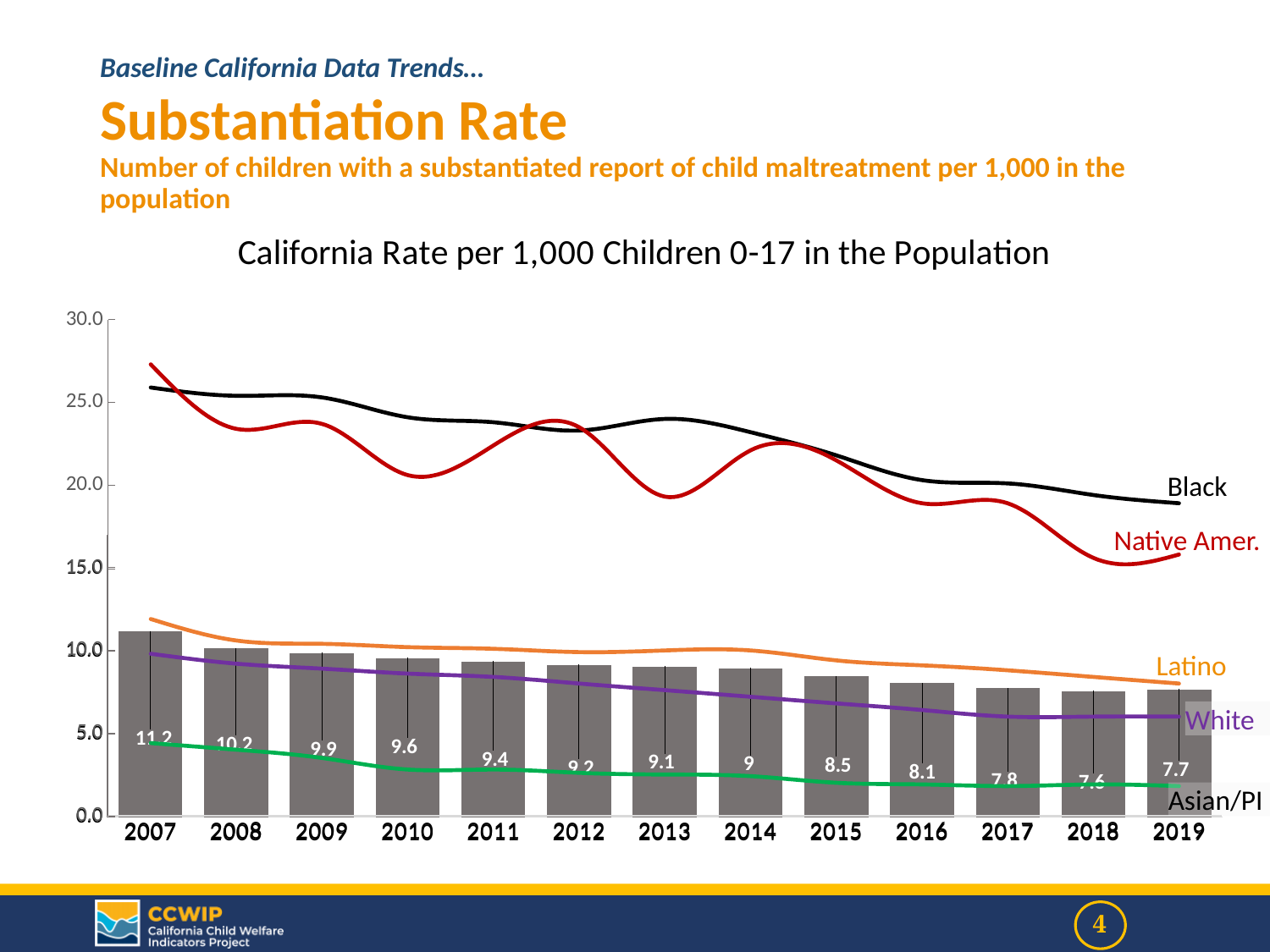
What is the title of the chart? California Rate per 1,000 Children 0-17 in the Population Is the value of the Native Amer. line in 2007 greater or less than 25.0? greater Do the bar values generally rise or fall from 2007 to 2019? fall What is the overall substantiation rate shown by the bar for 2007? 11.2 What is the value of the bar for 2015? 8.5 Which bar is larger, 2010 or 2014? 2010 Which year has the lowest bar value? 2018 What is the difference between the bar values for 2007 and 2019? 3.5 Is the value of the Black line in 2019 greater or less than 20.0? less Which year has the highest bar value? 2007 What is the value of the bar for 2019? 7.7 How many years are shown on the x axis? 13